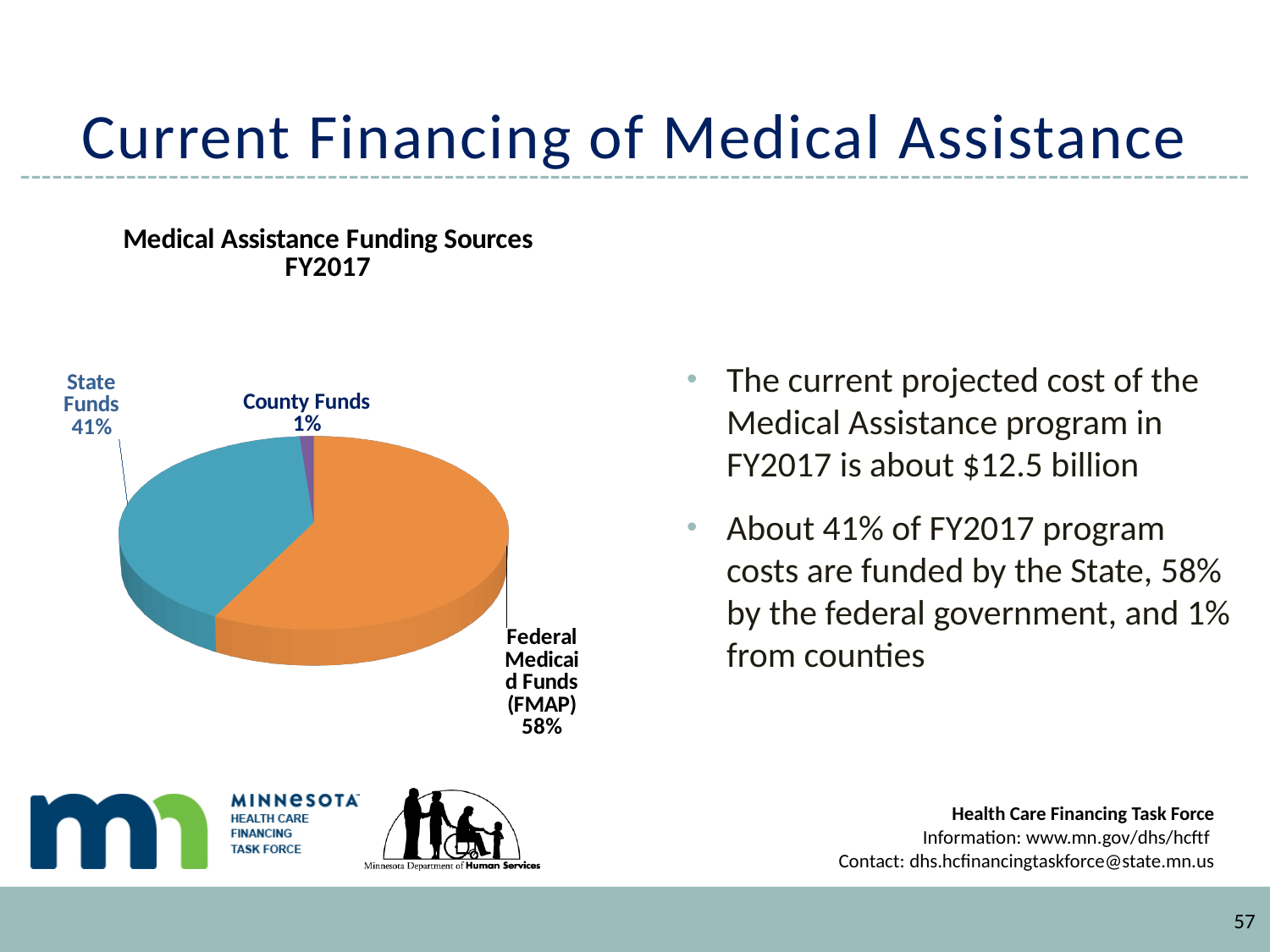
What is the title of the chart? Medical Assistance Funding Sources FY2017 What is the combined share of State Funds and County Funds? 42% What is the difference in percentage points between the Federal Medicaid Funds (FMAP) share and the State Funds share? 17 How many slices does the pie chart have? 3 Which is larger, the State Funds share or the County Funds share? State Funds What share of Medical Assistance funding comes from County Funds? 1% Which funding source has the largest share of the pie? Federal Medicaid Funds (FMAP) Which funding source has the smallest share of the pie? County Funds What kind of chart is shown on the slide? Pie chart What colour is the State Funds slice? Teal blue What share of Medical Assistance funding comes from Federal Medicaid Funds (FMAP)? 58% What share of Medical Assistance funding comes from State Funds? 41%